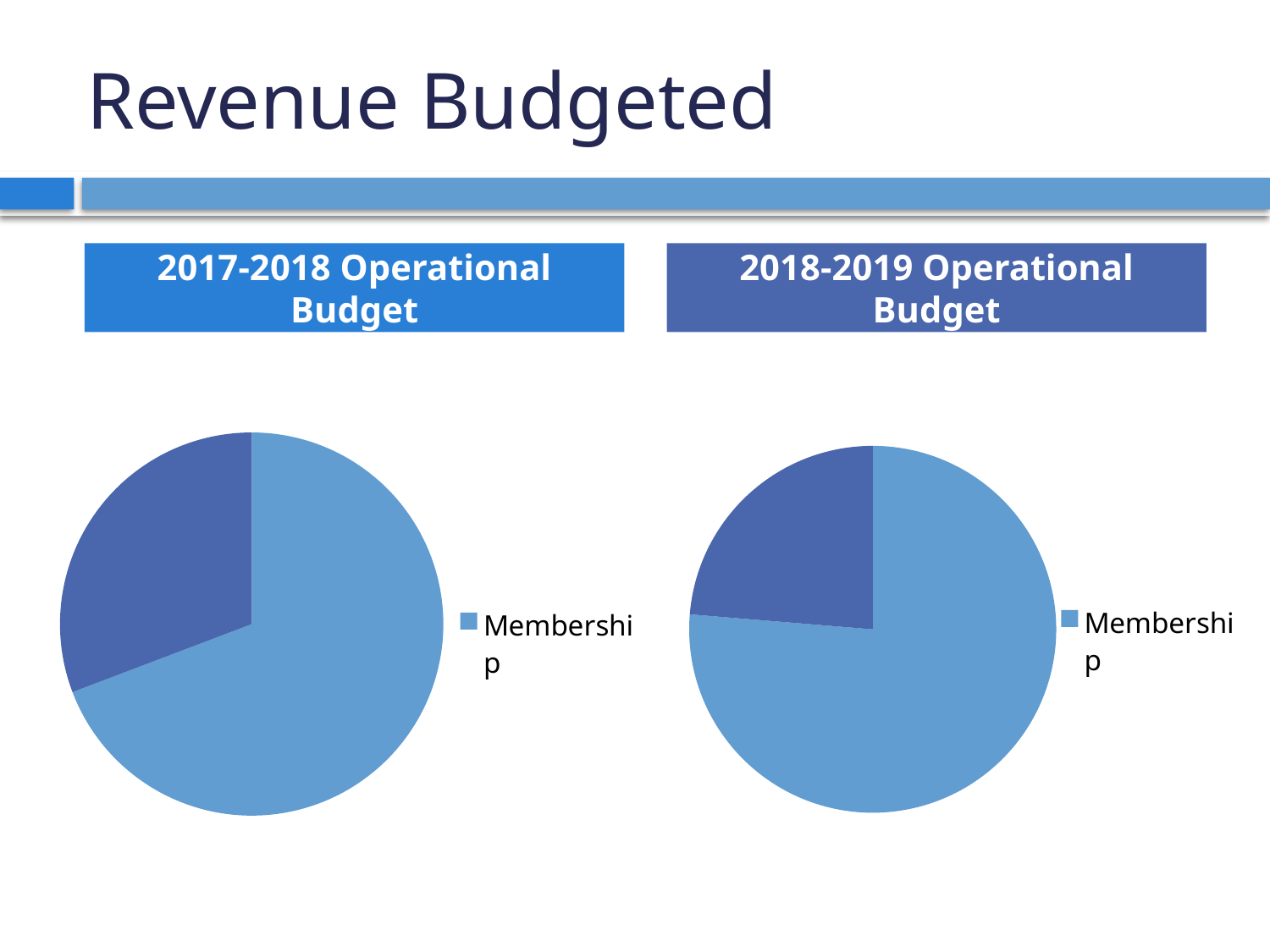
In the 2018-2019 Operational Budget chart, is the dark blue slice greater or less than half of the pie? less What is the title of the left chart? 2017-2018 Operational Budget In the 2017-2018 Operational Budget chart, which slice is larger, the light blue Membership slice or the dark blue slice? The light blue Membership slice How many slices does the 2018-2019 Operational Budget pie chart have? 2 What legend entry is shown next to the 2018-2019 Operational Budget chart? Membership How many slices does the 2017-2018 Operational Budget pie chart have? 2 In the 2017-2018 Operational Budget chart, is the Membership slice greater or less than half of the pie? greater What kind of chart is the 2017-2018 Operational Budget chart? Pie chart In the 2018-2019 Operational Budget chart, which slice is larger, the light blue Membership slice or the dark blue slice? The light blue Membership slice How many charts are on the slide? 2 What kind of chart is the 2018-2019 Operational Budget chart? Pie chart